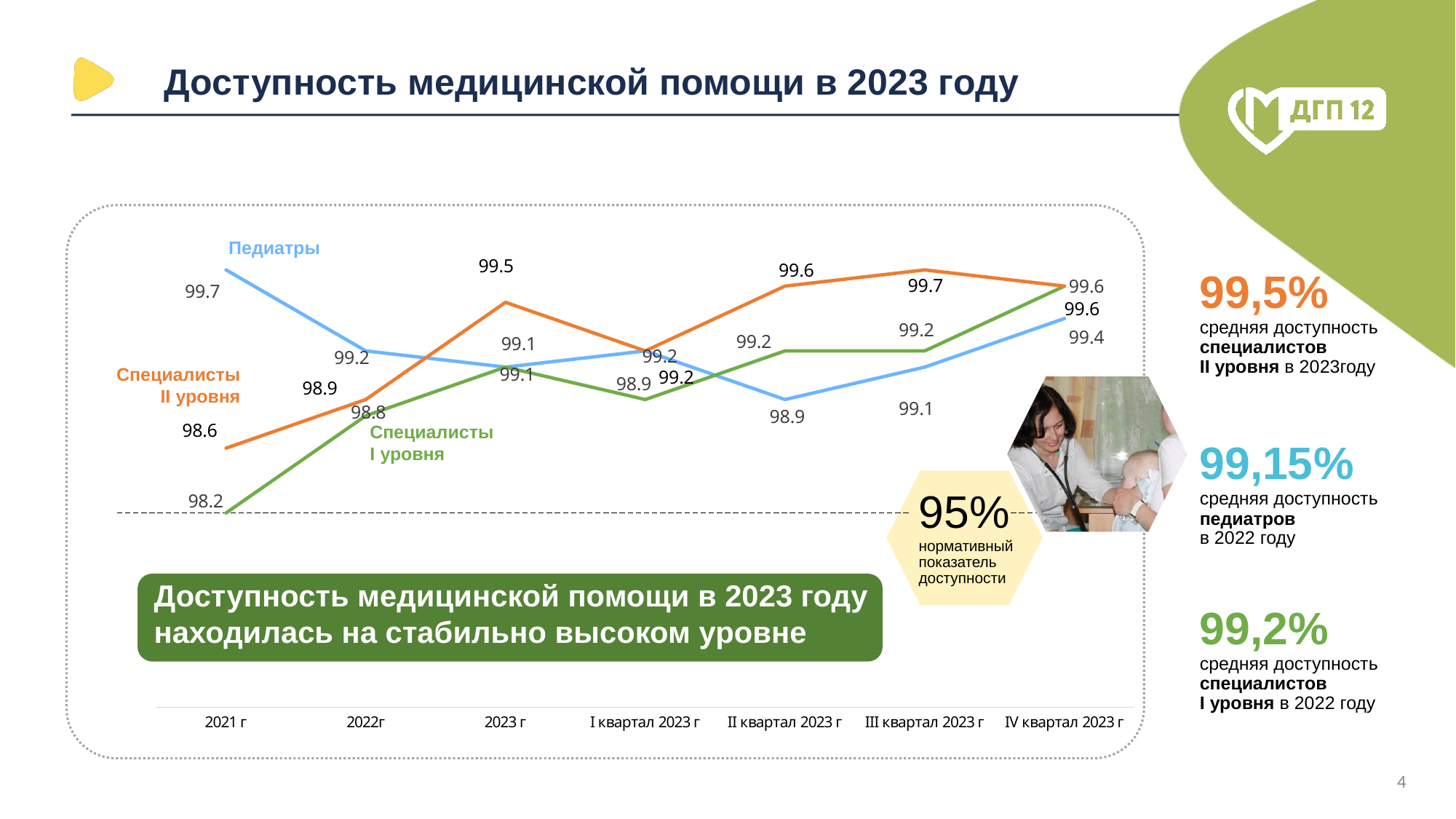
How many series (lines) are plotted on the chart? 3 What kind of chart is shown on the slide? line chart In which category does the Педиатры line reach its highest value? 2021 г In which category does the Специалисты I уровня line have its lowest value? 2021 г How many categories are shown along the x axis of the chart? 7 What is the value for Педиатры in 2021 г? 99.7 In 2021 г, which is higher: Педиатры or Специалисты II уровня? Педиатры What is the value for Педиатры in II квартал 2023 г? 98.9 What is the difference between the Педиатры values for 2021 г and 2022г? 0.5 What is the value for Специалисты II уровня in III квартал 2023 г? 99.7 Does the Специалисты I уровня line rise or fall from 2021 г to 2023 г? rise What is the value for Специалисты I уровня in 2021 г? 98.2